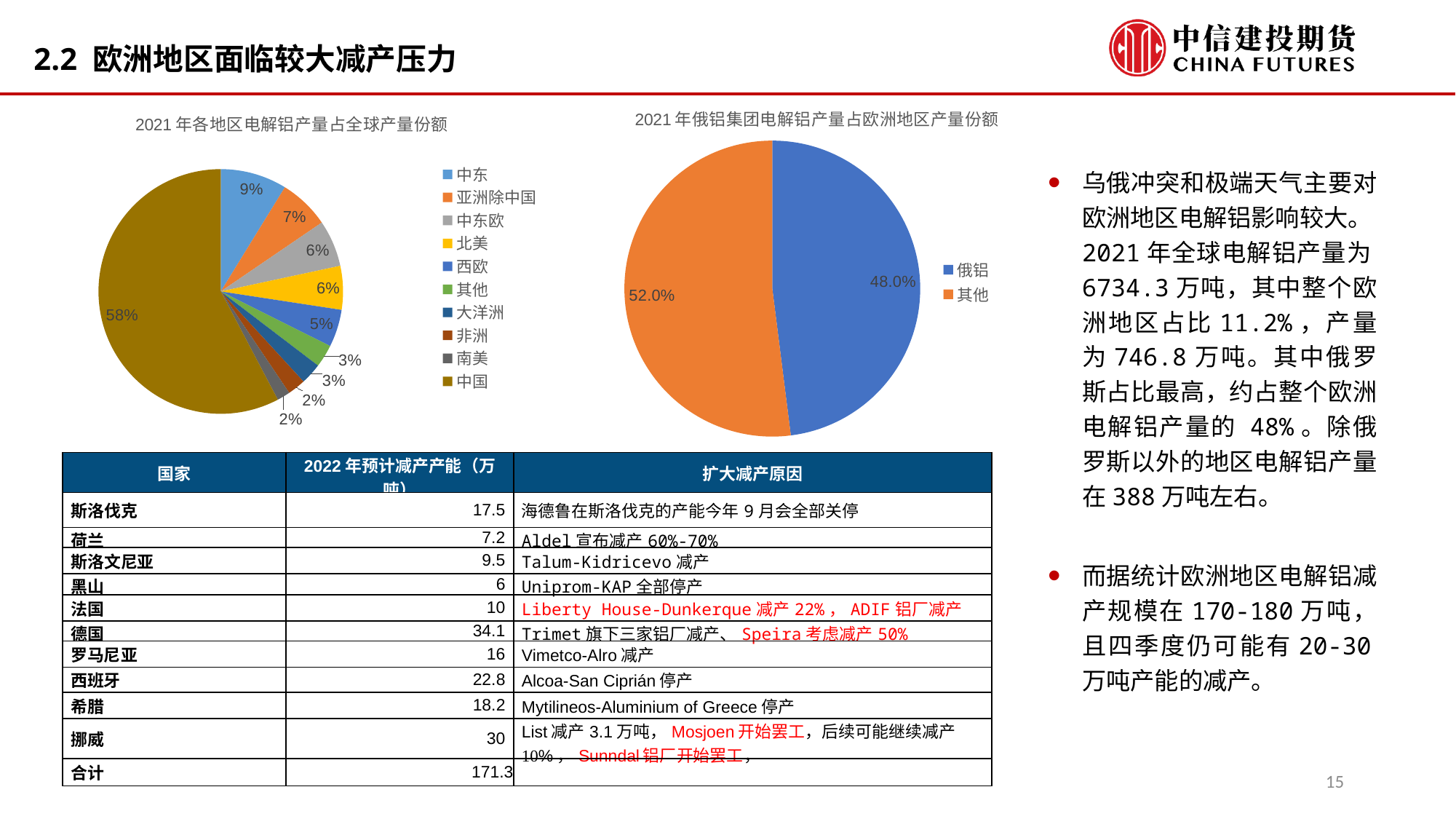
In the right pie chart (2021年俄铝集团电解铝产量占欧洲地区产量份额), which slice is larger, 俄铝 or 其他? 其他 In the left pie chart (2021年各地区电解铝产量占全球产量份额), which is larger, the share of 中东 or the share of 亚洲除中国? 中东 In the left pie chart (2021年各地区电解铝产量占全球产量份额), what share does 中国 have? 58% In the right pie chart (2021年俄铝集团电解铝产量占欧洲地区产量份额), what share does 其他 have? 52.0% What is the title of the left chart on the slide? 2021年各地区电解铝产量占全球产量份额 In the left pie chart (2021年各地区电解铝产量占全球产量份额), what is the difference between the share of 中国 and the share of 中东? 49% In the right pie chart (2021年俄铝集团电解铝产量占欧洲地区产量份额), what share does 俄铝 have? 48.0% In the left pie chart (2021年各地区电解铝产量占全球产量份额), which region has the largest share? 中国 In the left pie chart (2021年各地区电解铝产量占全球产量份额), what share does 西欧 have? 5% How many categories does the legend of the left pie chart (2021年各地区电解铝产量占全球产量份额) list? 10 What type of chart is the right chart (2021年俄铝集团电解铝产量占欧洲地区产量份额)? Pie chart In the left pie chart (2021年各地区电解铝产量占全球产量份额), what share does 中东 have? 9%